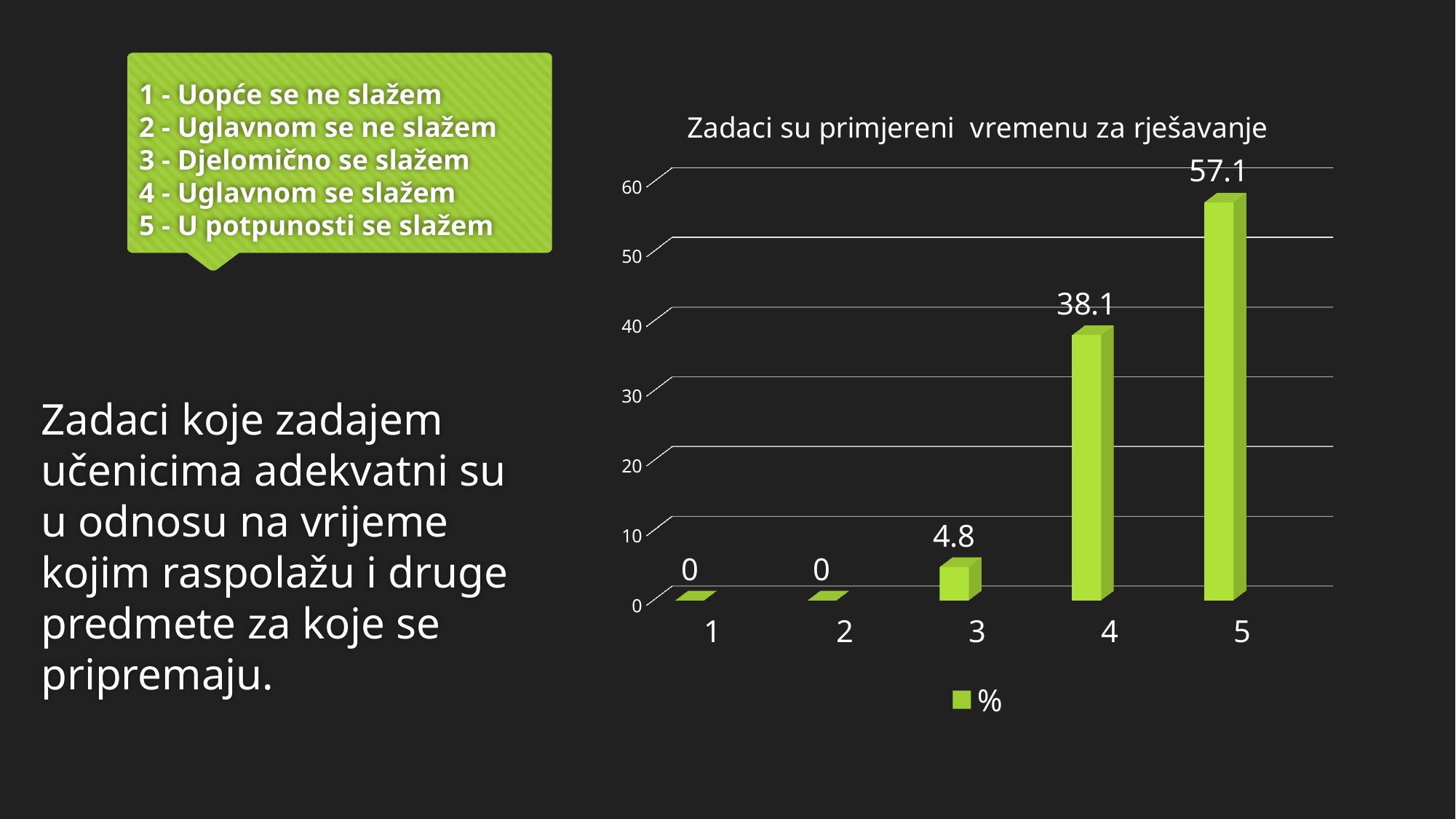
How many categories are shown on the x axis? 5 What is the difference between the values for categories 5 and 4? 19 What is the value for category 3? 4.8 What is the value for category 5? 57.1 What is the value for category 4? 38.1 How many series does the legend list? 1 What kind of chart is shown? bar chart What is the value for category 1? 0 What is the title of the chart? Zadaci su primjereni vremenu za rješavanje Is the value for category 5 greater or less than 50? greater Which is larger, the value for category 3 or the value for category 4? 4 Which category has the highest value? 5